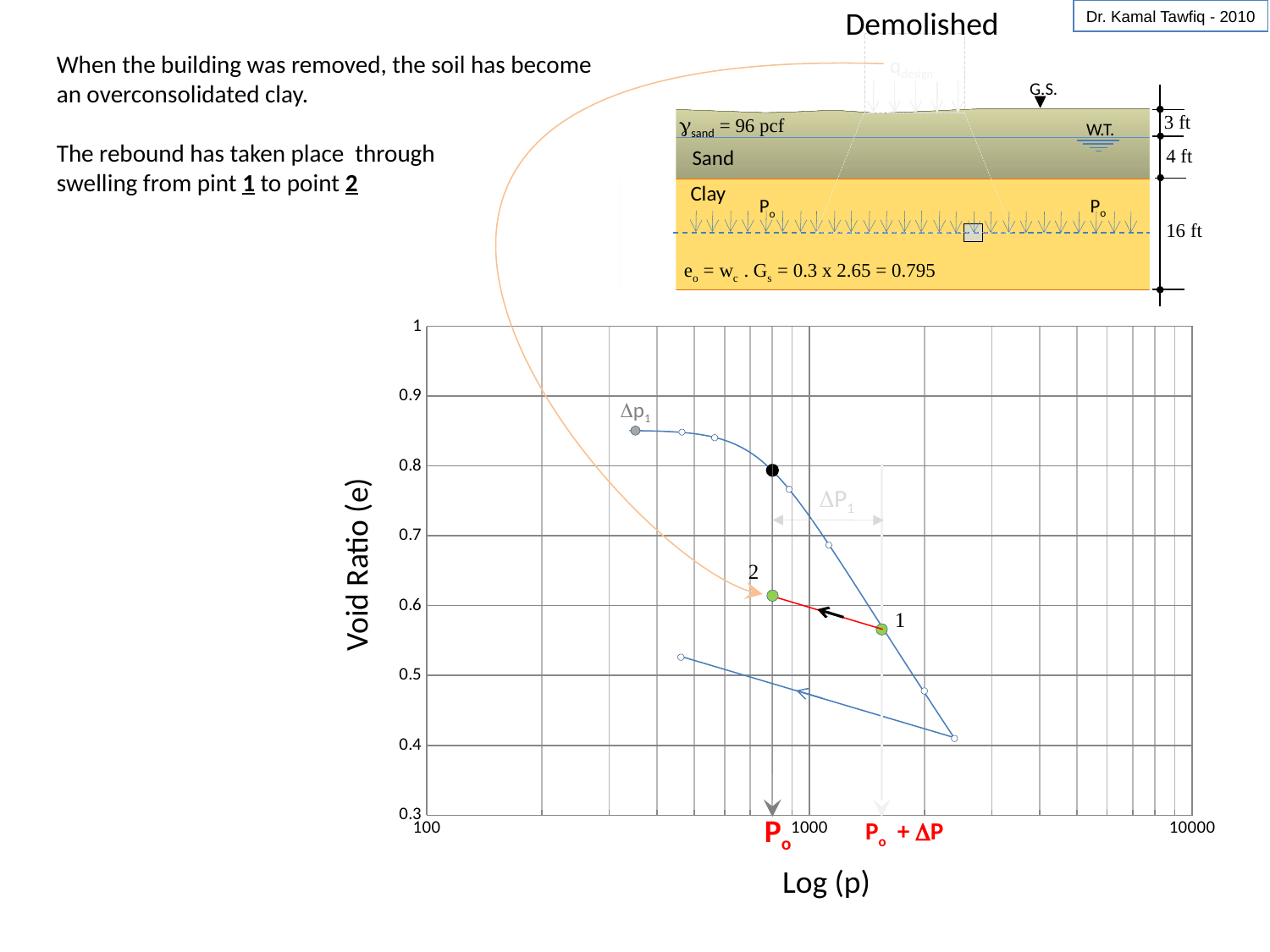
Is the void ratio at the lowest point of the curve greater or less than 0.5? less What is the highest value shown on the vertical axis of the chart? 1 Along the main loading curve, does the void ratio rise or fall as the pressure p increases? fall Which has the higher void ratio, point 1 or point 2? point 2 What is the title of the horizontal axis of the chart? Log (p) What kind of chart is shown on the slide? line chart Is the void ratio at point 1 greater or less than 0.6? less Is the void ratio at point 2 greater or less than 0.6? greater What is the title of the vertical axis of the chart? Void Ratio (e)